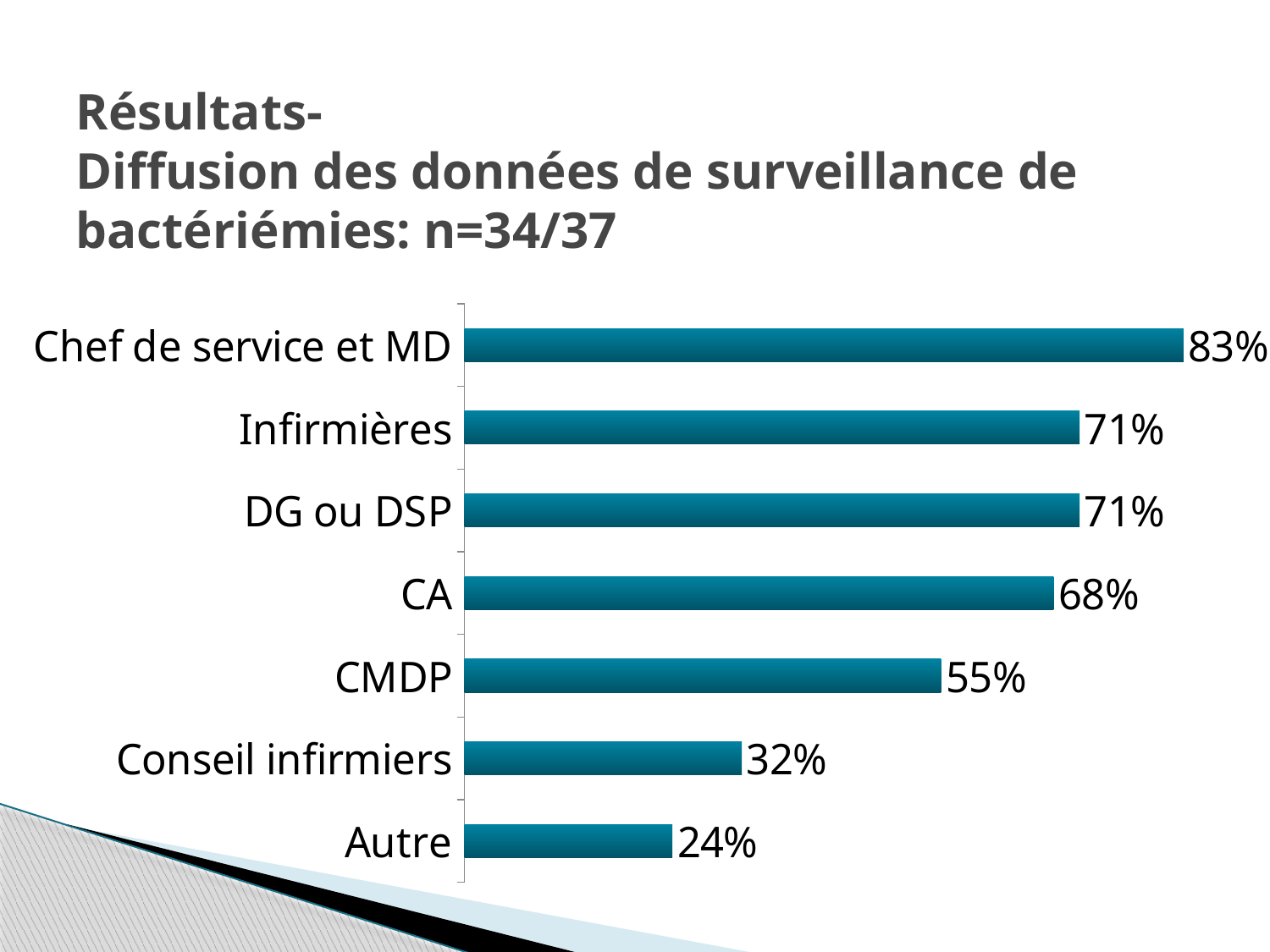
What is the difference between the values for CA and CMDP? 13% What is the value for Chef de service et MD? 83% How many categories are shown in the chart? 7 What is the value for Conseil infirmiers? 32% Which category has the lowest value? Autre What is the value for CMDP? 55% Which category has the highest value? Chef de service et MD Which two categories share the same value of 71%? Infirmières and DG ou DSP What is the difference between the values for Chef de service et MD and Autre? 59% Which is larger, the value for CMDP or the value for Conseil infirmiers? CMDP What is the value for Autre? 24% What kind of chart is shown on the slide? Bar chart